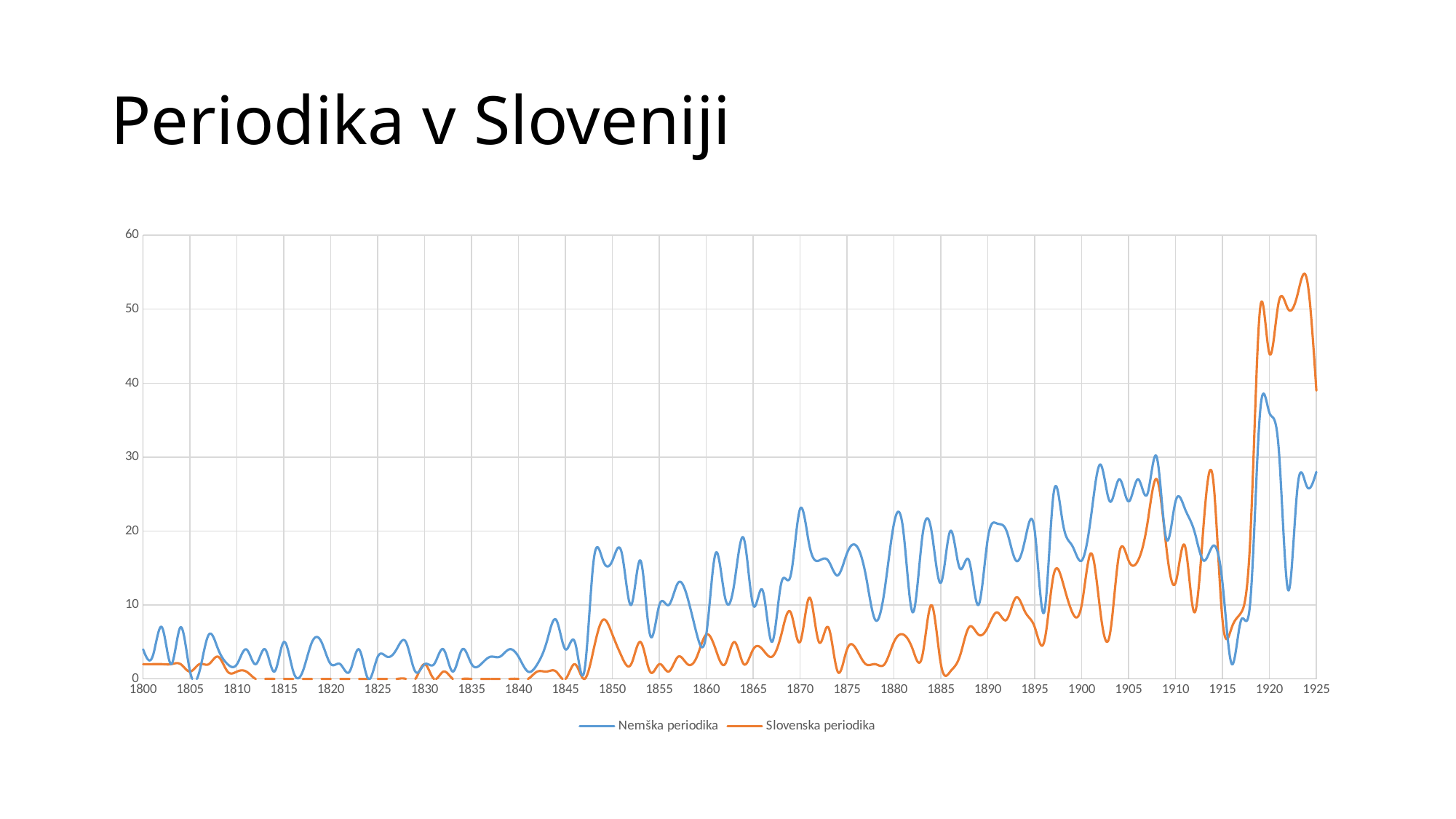
Is the value for Slovenska periodika around 1924 greater or less than 50? greater Is the value for Nemška periodika in 1916 greater or less than 10? less What is the title of the slide containing the chart? Periodika v Sloveniji Is the value for Nemška periodika in 1919 greater or less than 30? greater What kind of chart is shown on the slide? line chart How many series does the legend list? 2 In 1850, which series has the higher value, Nemška periodika or Slovenska periodika? Nemška periodika Which series reaches the highest value anywhere on the chart? Slovenska periodika In 1925, which series has the higher value, Nemška periodika or Slovenska periodika? Slovenska periodika What are the two series named in the legend? Nemška periodika and Slovenska periodika